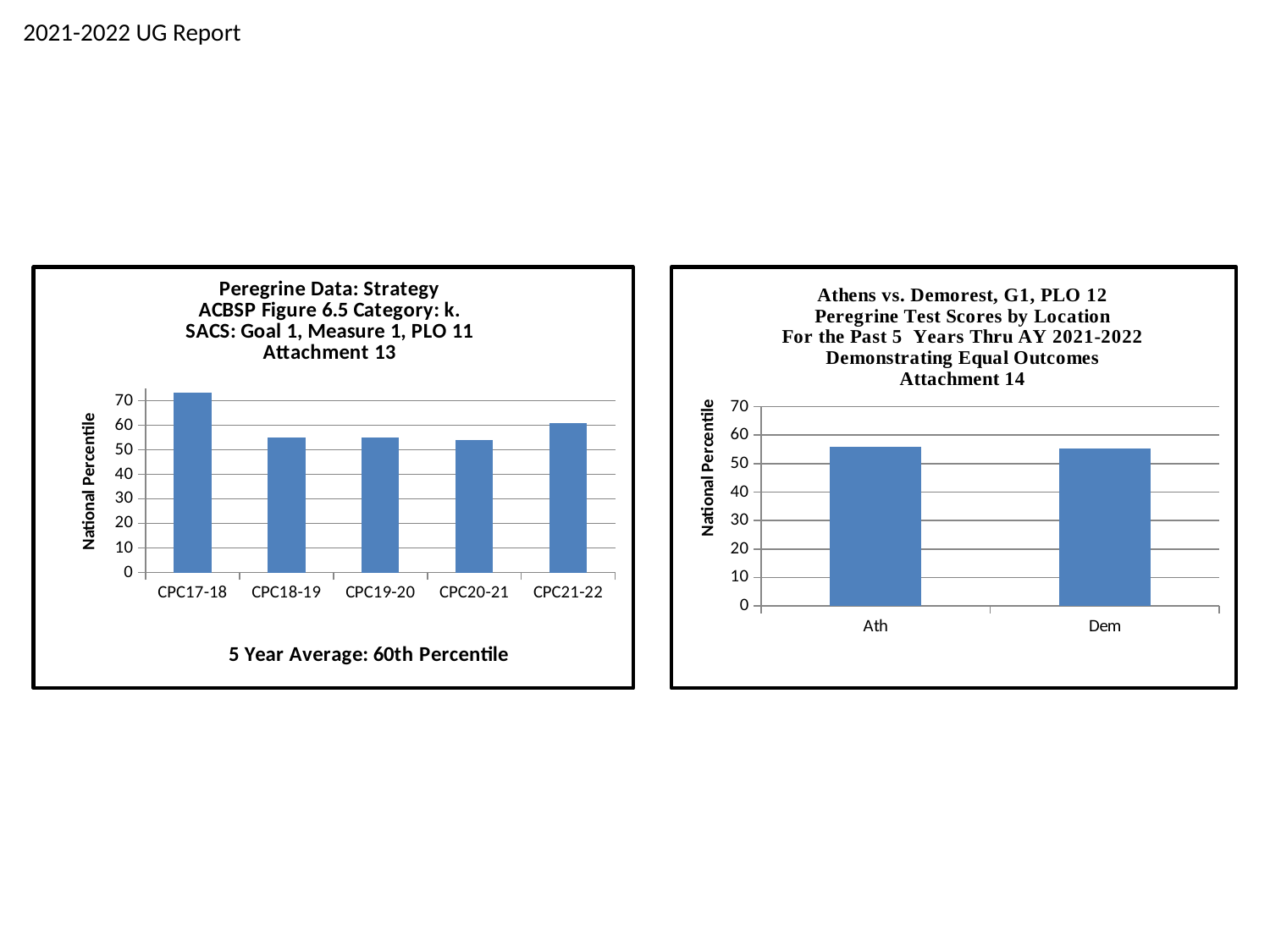
What 5 year average is stated below the left chart (Peregrine Data: Strategy)? 60th Percentile In the right chart (Athens vs. Demorest), is the value for Dem greater or less than 60? less In the left chart (Peregrine Data: Strategy), how many categories are shown on the x axis? 5 In the left chart (Peregrine Data: Strategy), which is larger, the value for CPC20-21 or the value for CPC21-22? CPC21-22 In the right chart (Athens vs. Demorest), how many categories are shown on the x axis? 2 What kind of chart is the left chart titled "Peregrine Data: Strategy"? bar chart In the left chart (Peregrine Data: Strategy), which category has the highest value? CPC17-18 In the right chart (Athens vs. Demorest), is the value for Ath greater or less than 50? greater In the left chart (Peregrine Data: Strategy), is the value for CPC21-22 greater or less than 50? greater In the left chart (Peregrine Data: Strategy), which is larger, the value for CPC17-18 or the value for CPC21-22? CPC17-18